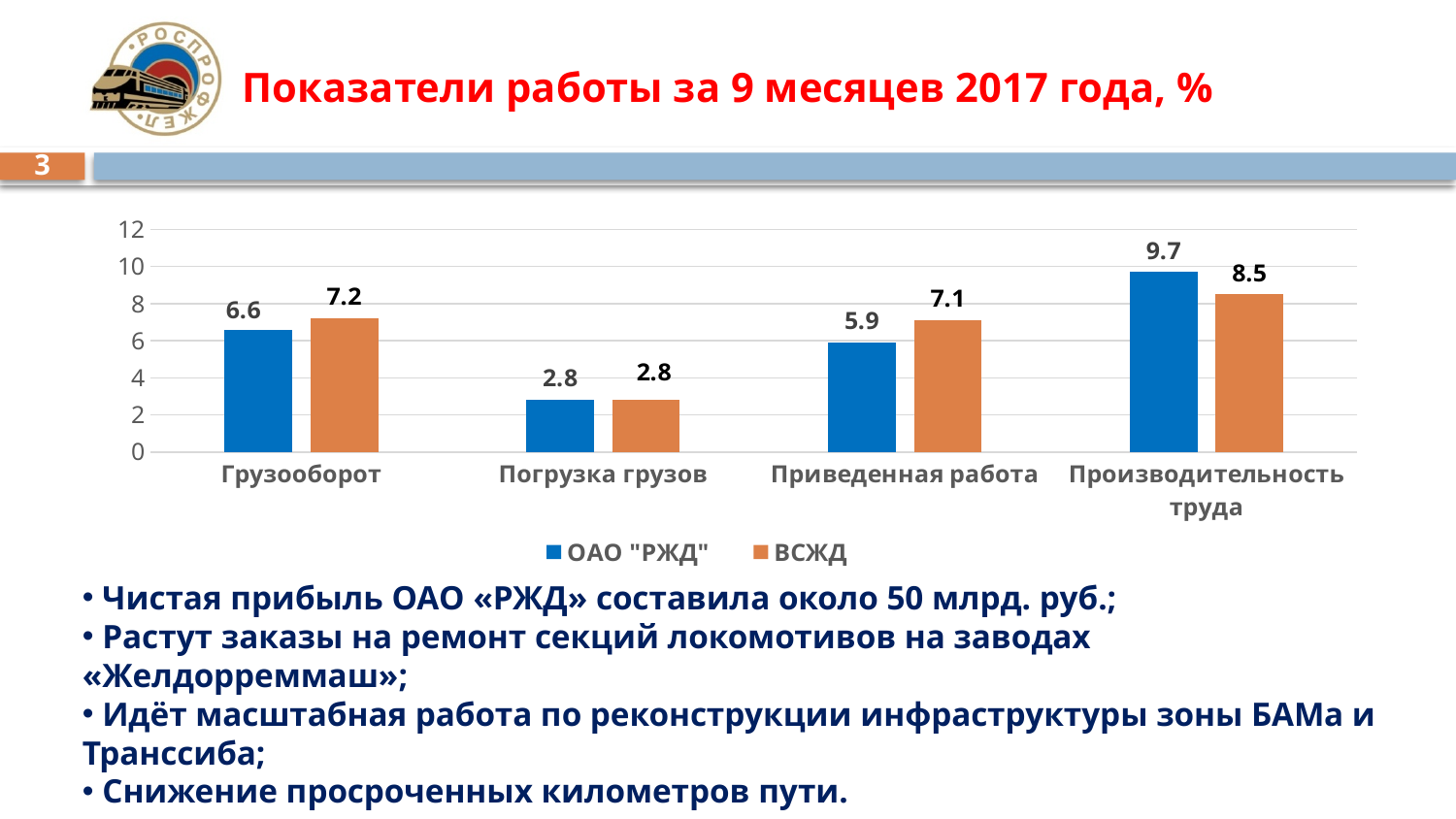
What is the value for ВСЖД in the Приведенная работа category? 7.1 How many categories are shown on the x axis? 4 Is the value for ВСЖД in the Грузооборот category greater or less than 6? greater What is the difference between the ОАО "РЖД" and ВСЖД values in the Производительность труда category? 1.2 How many series does the legend list? 2 What is the title of the slide containing the chart? Показатели работы за 9 месяцев 2017 года, % What is the value for ОАО "РЖД" in the Грузооборот category? 6.6 Which is larger in the Приведенная работа category: ОАО "РЖД" or ВСЖД? ВСЖД Which category has the lowest value for ВСЖД? Погрузка грузов What is the value for ВСЖД in the Производительность труда category? 8.5 Which category has the highest value for ОАО "РЖД"? Производительность труда What kind of chart is shown on the slide? Bar chart